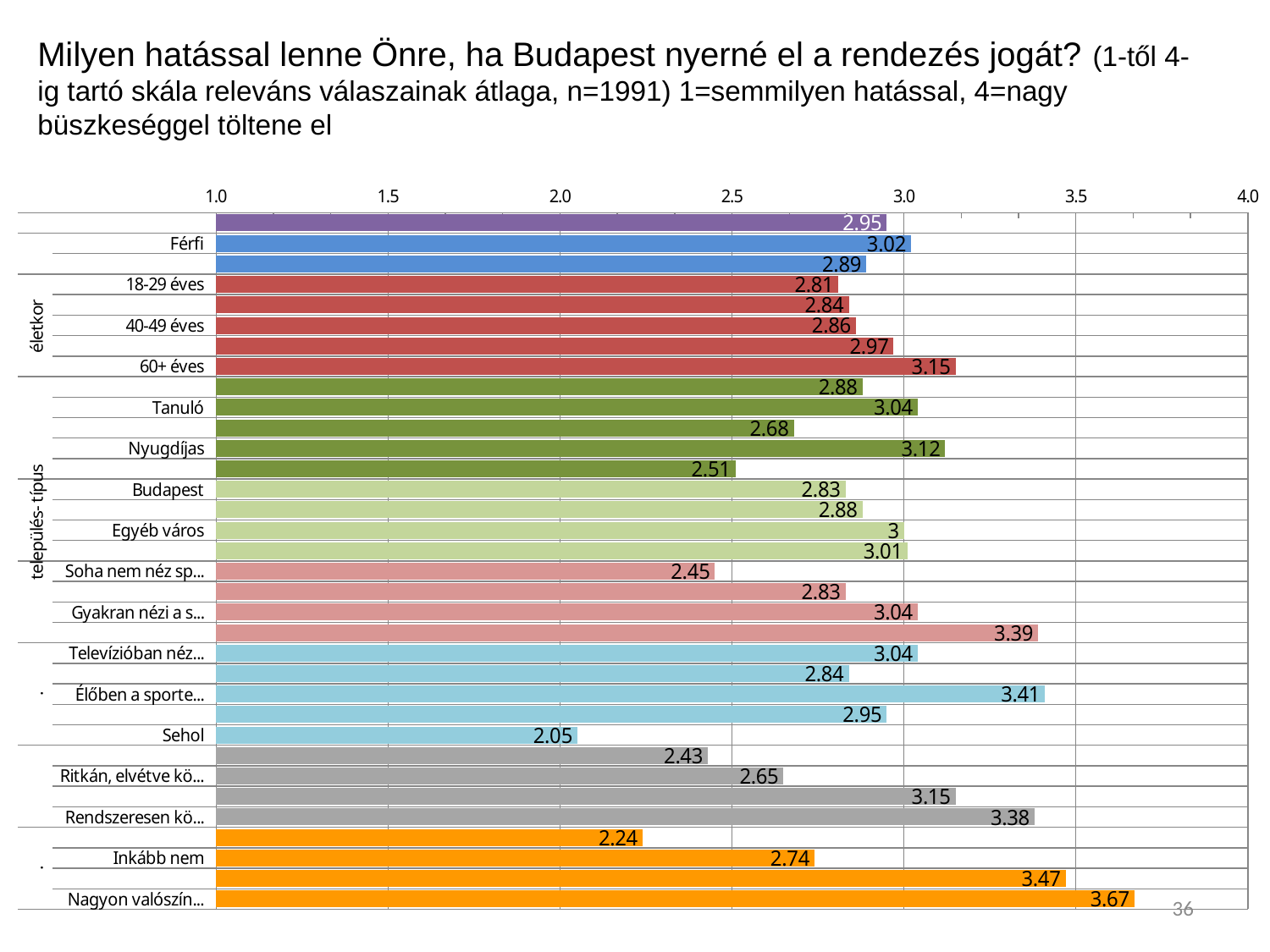
What is the difference between the values for 60+ éves and 18-29 éves? 0.34 What is the value for 60+ éves? 3.15 Which labelled category has the lowest value on the chart? Sehol What is the value for Nyugdíjas? 3.12 What is the difference between the values for Nyugdíjas and Tanuló? 0.08 What kind of chart is shown on the slide? bar chart What is the value for Egyéb város? 3 Is the value for Inkább nem greater or less than 3.0? less Which is larger, the value for Budapest or the value for Egyéb város? Egyéb város What is the value for Férfi? 3.02 Among the age groups 18-29 éves, 40-49 éves and 60+ éves, which has the highest value? 60+ éves What is the value for Sehol? 2.05